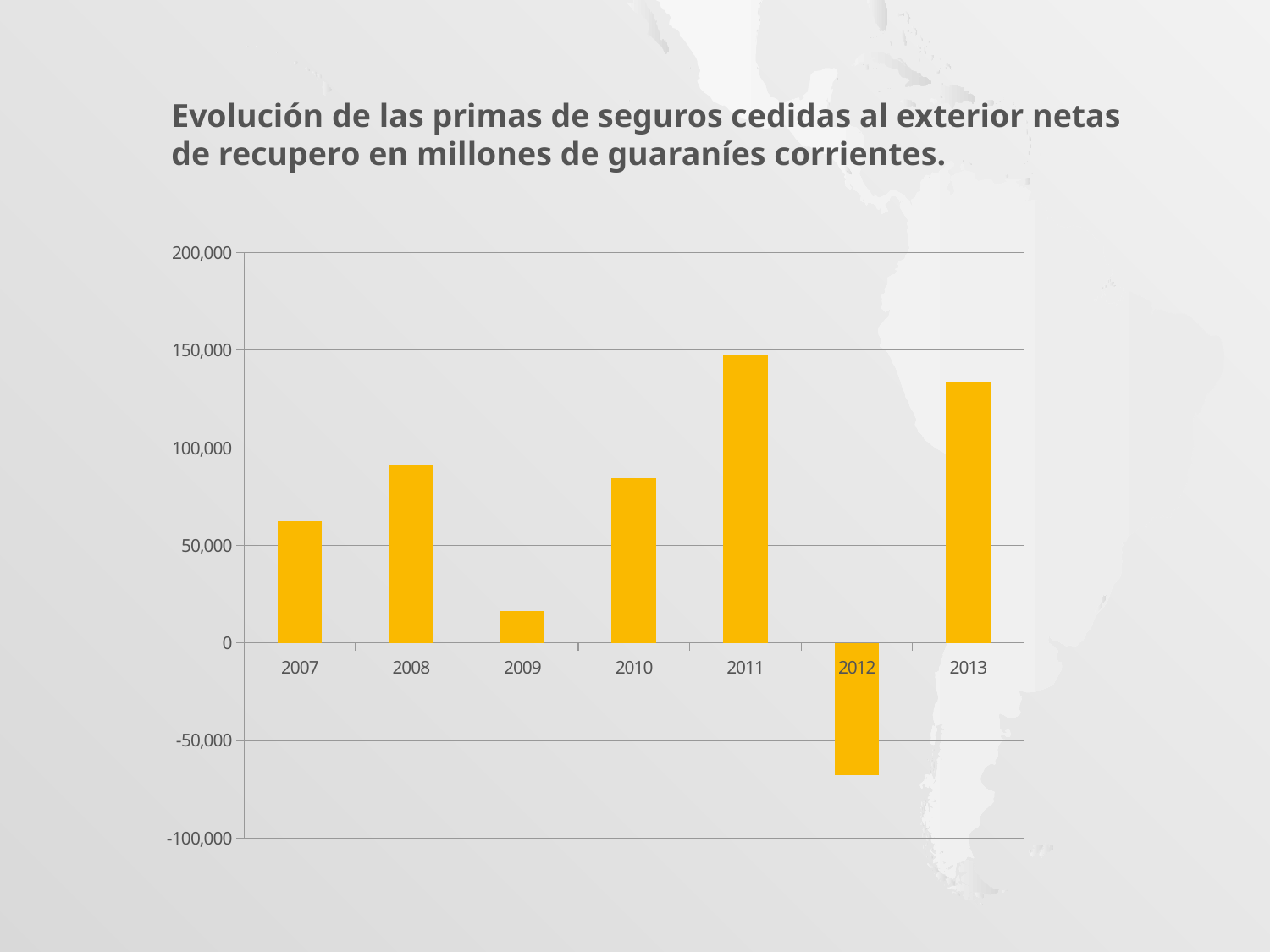
Is the value for 2012 greater or less than -50,000? less Is the value for 2013 greater or less than 100,000? greater Which year has the highest value in the chart? 2011 Which year has the lowest value in the chart? 2012 Which year has the larger value, 2007 or 2009? 2007 Which year is the only one with a negative value? 2012 Is the value for 2008 greater or less than 100,000? less How many years are shown on the x axis of the chart? 7 Which year has the larger value, 2011 or 2013? 2011 What kind of chart is shown on the slide? bar chart